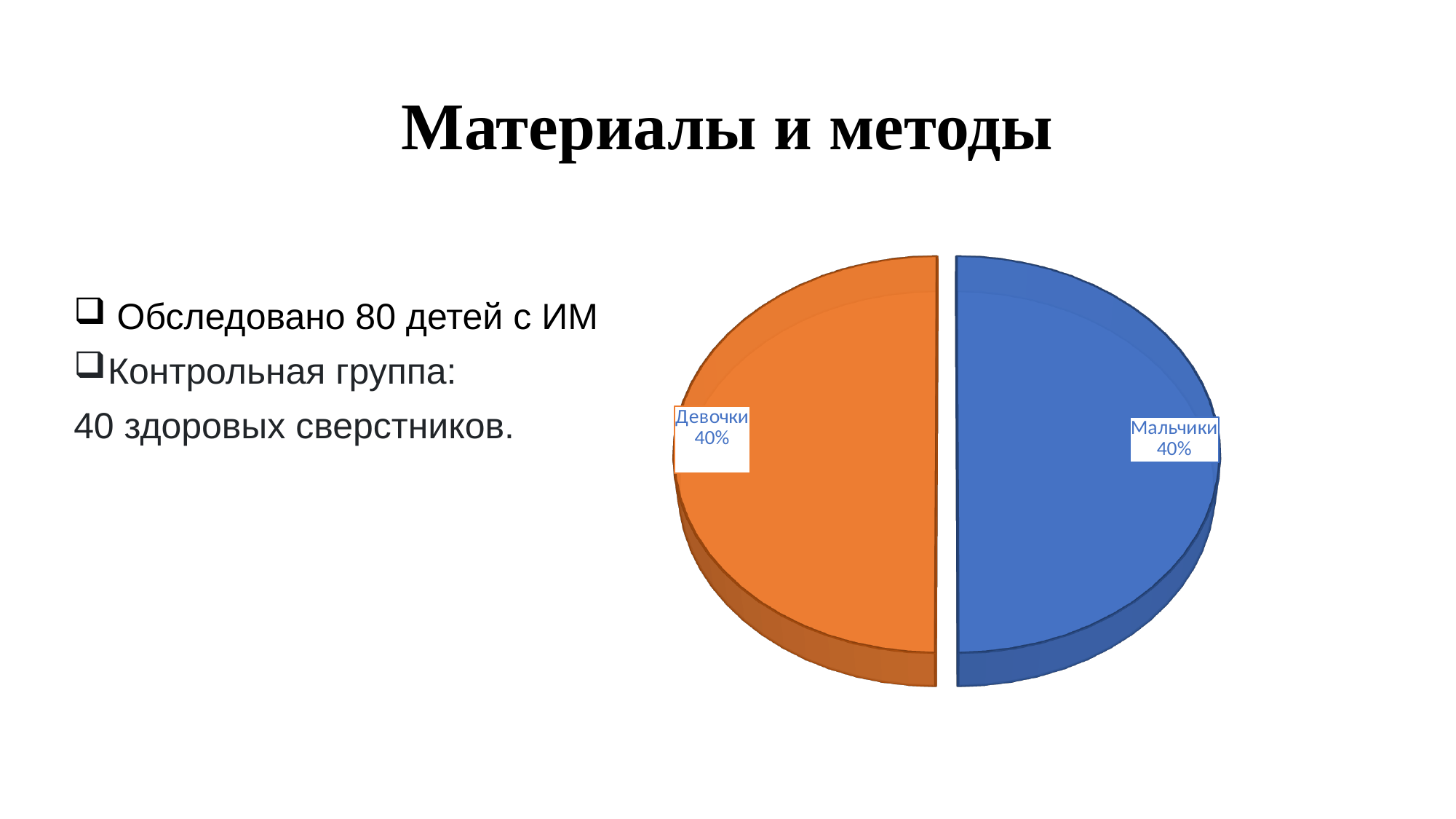
Which colour is the Девочки slice of the pie chart? orange What value is shown for the Девочки slice of the pie chart? 40% What is the difference between the labelled values for Девочки and Мальчики? 0% Which colour is the Мальчики slice of the pie chart? blue How many slices does the pie chart have? 2 What value is shown for the Мальчики slice of the pie chart? 40% What kind of chart is shown on the slide? pie chart What are the two categories labelled on the pie chart? Девочки and Мальчики